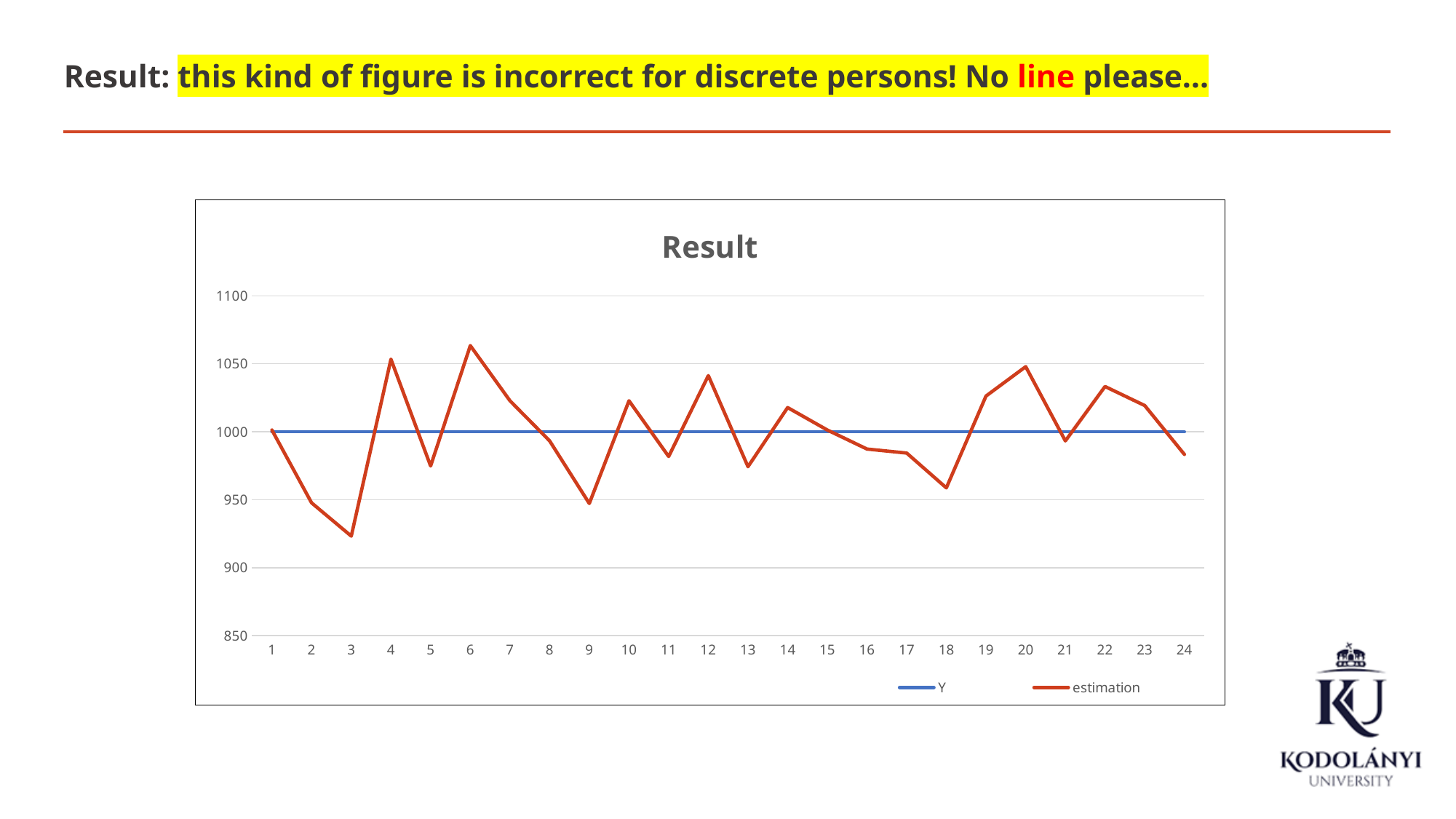
Does the estimation series rise or fall from point 1 to point 3? fall Is the estimation value at point 3 greater or less than 950? less Which is larger, the estimation value at point 3 or at point 9? point 9 At which x-axis point does the estimation series reach its lowest value? 3 Is the estimation value at point 12 greater or less than 1050? less Is the estimation value at point 6 greater or less than 1050? greater How many points are plotted along the x axis? 24 How many series does the legend list? 2 What is the title of the chart? Result What is the value of the Y series at point 10? 1000 At which x-axis point does the estimation series reach its highest value? 6 What kind of chart is shown on the slide? line chart